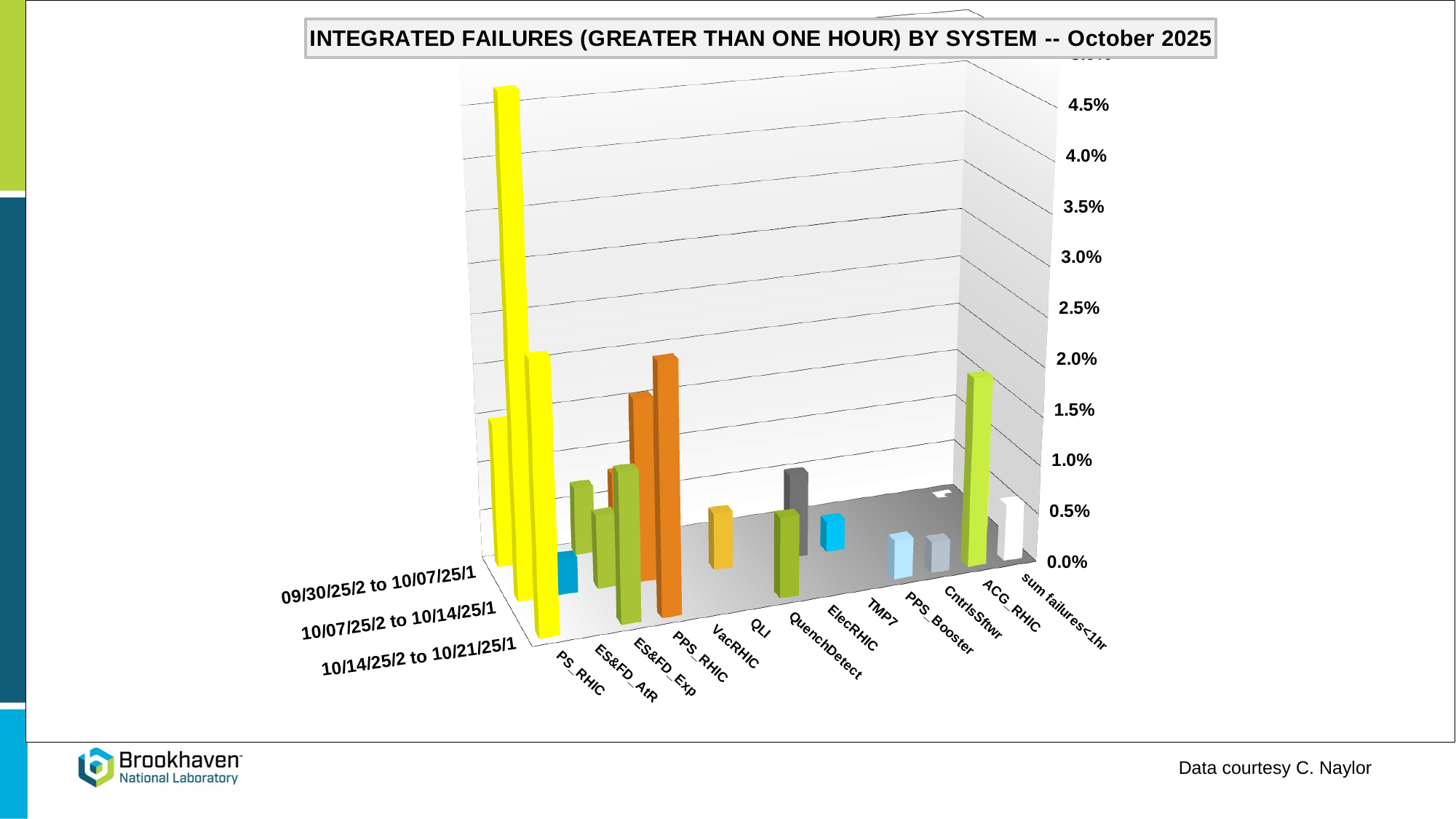
Which system has the tallest bar in the chart? PS_RHIC What kind of chart is shown on the slide? bar chart Which is larger, the tallest bar for PS_RHIC or the tallest bar for PPS_RHIC? PS_RHIC Is the value for sum failures<1hr greater or less than 1.0%? less Which time period is listed first (at the back) on the depth axis? 09/30/25/2 to 10/07/25/1 How many weekly time periods (series) are plotted in the chart? 3 Which is larger, the tallest bar for PPS_RHIC or the bar for TMP7? PPS_RHIC Is the tallest bar for PS_RHIC greater or less than 3.0%? greater How many system categories are shown along the x axis of the chart? 13 What is the highest labelled value on the vertical axis that is fully readable? 4.5% What is the title of the chart? INTEGRATED FAILURES (GREATER THAN ONE HOUR) BY SYSTEM -- October 2025